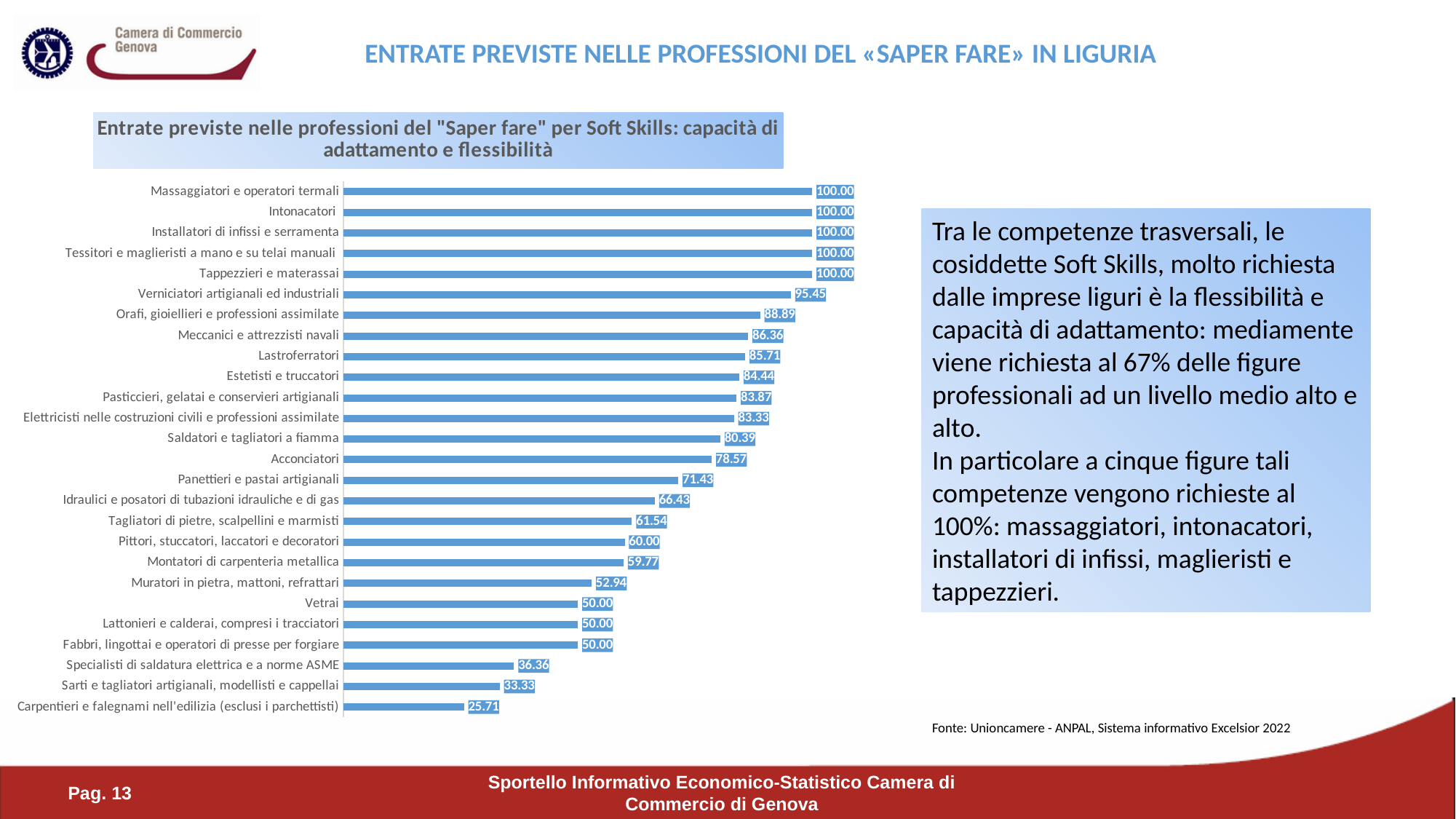
Which is larger: the value for Saldatori e tagliatori a fiamma or the value for Tagliatori di pietre, scalpellini e marmisti? Saldatori e tagliatori a fiamma What is the value for Sarti e tagliatori artigianali, modellisti e cappellai? 33.33 What is the value for Verniciatori artigianali ed industriali? 95.45 What is the value for Muratori in pietra, mattoni, refrattari? 52.94 What is the difference between the values for Panettieri e pastai artigianali and Idraulici e posatori di tubazioni idrauliche e di gas? 5.00 How many categories are shown in the chart? 26 What kind of chart is shown on the slide? Bar chart What is the difference between the values for Orafi, gioiellieri e professioni assimilate and Meccanici e attrezzisti navali? 2.53 What is the highest value shown in the chart? 100.00 Which category has the lowest value? Carpentieri e falegnami nell'edilizia (esclusi i parchettisti) What is the value for Acconciatori? 78.57 What is the title of the chart? Entrate previste nelle professioni del "Saper fare" per Soft Skills: capacità di adattamento e flessibilità